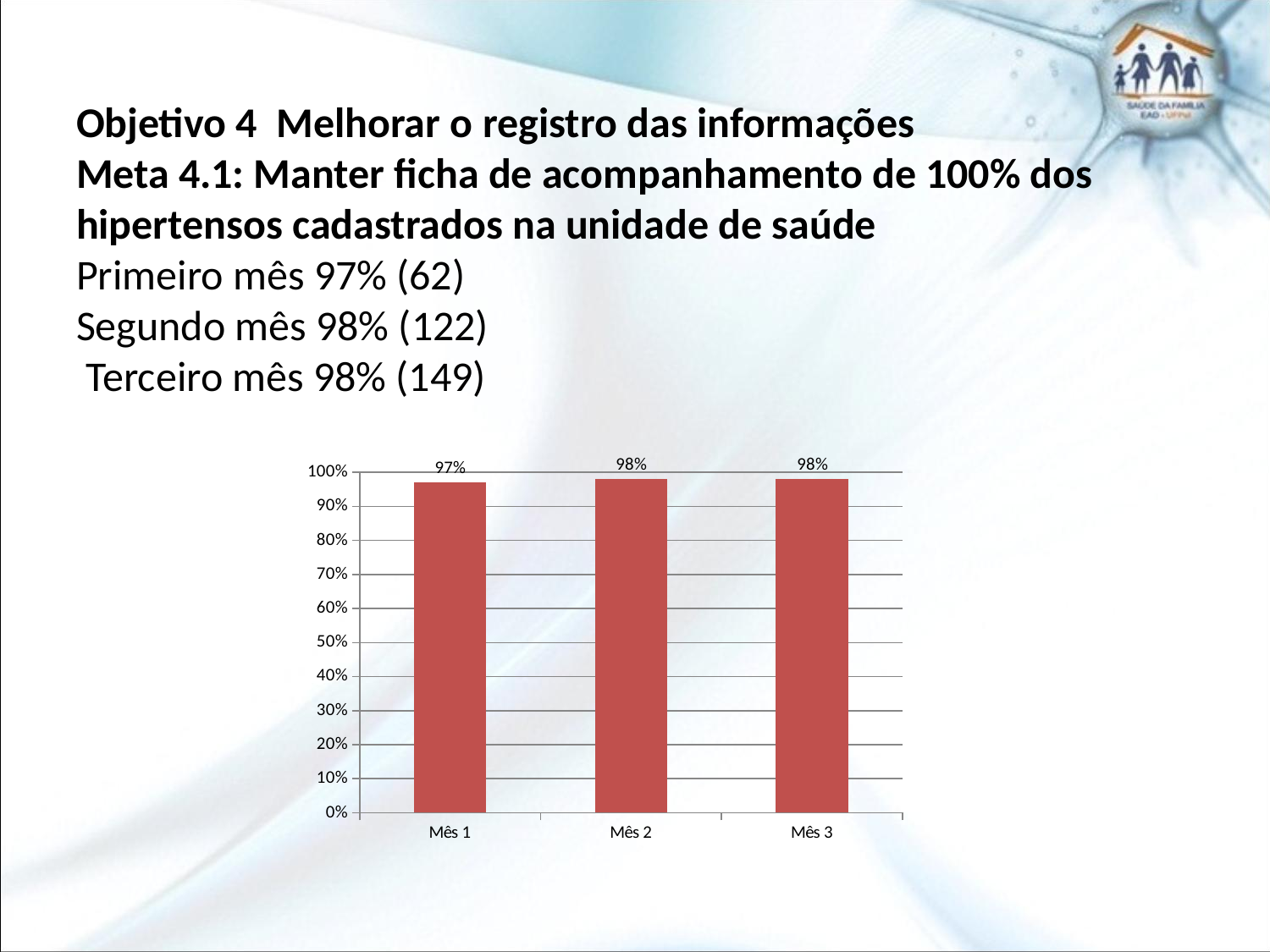
How many categories are shown on the x axis? 3 What is the highest tick value shown on the y axis? 100% What is the value for Mês 2? 98% What kind of chart is shown on the slide? bar chart What is the value for Mês 1? 97% What is the difference between the values for Mês 2 and Mês 1? 1% What is the value for Mês 3? 98% Do the values rise or fall from Mês 1 to Mês 2? rise Which is larger, the value for Mês 1 or the value for Mês 2? Mês 2 Which category has the lowest value? Mês 1 Is the value for Mês 3 greater or less than 90%? greater What colour are the bars in the chart? red